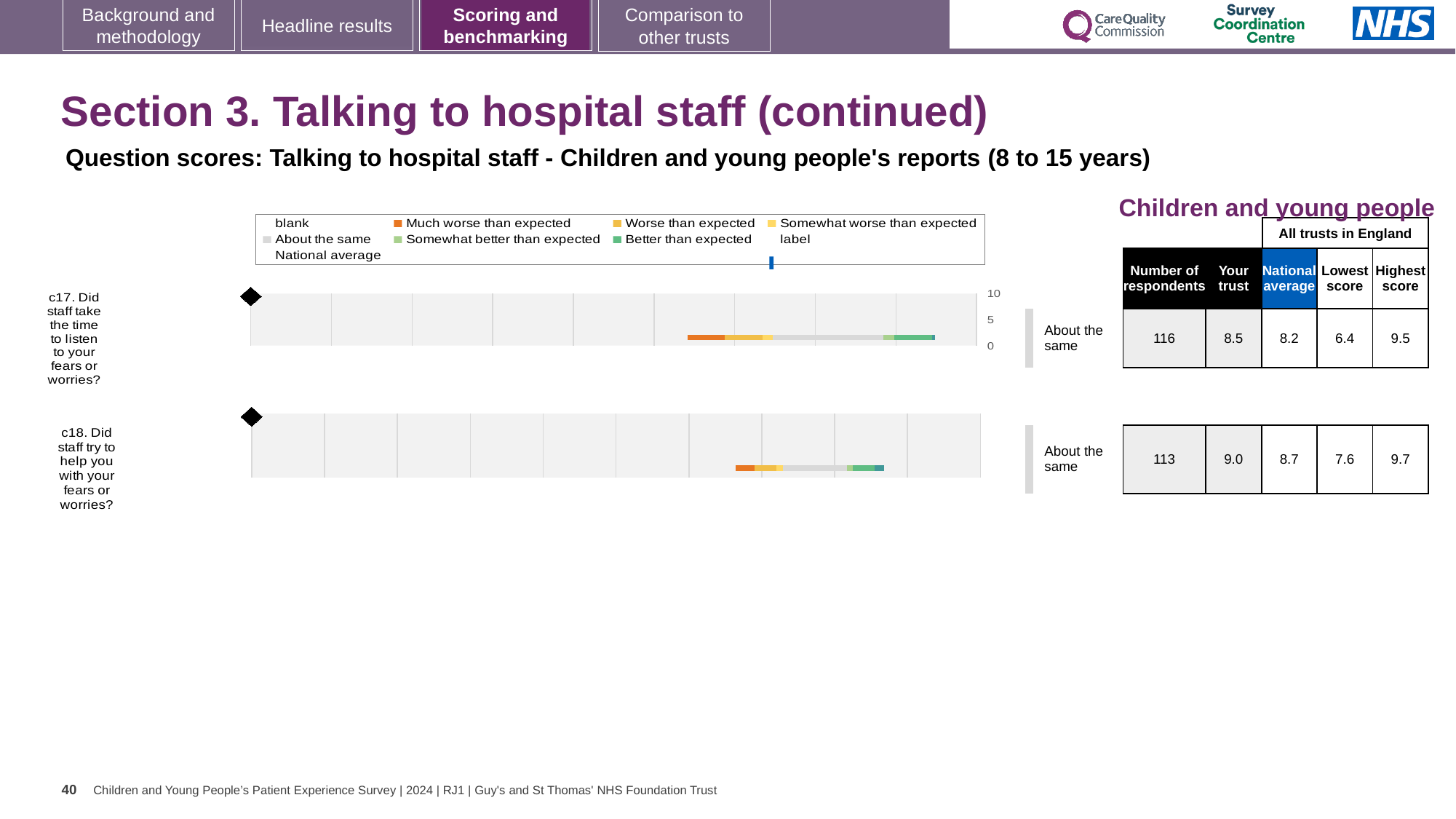
What is the difference between the highest and lowest scores across all trusts in England for c17? 3.1 What is the highest score among all trusts in England for c17? 9.5 What benchmark category is shown next to the c17 chart? About the same What is the 'Your trust' score for c17 (Did staff take the time to listen to your fears or worries?)? 8.5 What is the difference between the trust's score and the national average for c18? 0.3 How many survey questions are plotted on the slide? 2 What is the lowest score among all trusts in England for c18? 7.6 How many respondents answered c17? 116 What type of chart is used to show the question scores for c17 and c18? bar chart Which question has the higher 'Your trust' score, c17 or c18? c18 What is the national average score for c18 (Did staff try to help you with your fears or worries?)? 8.7 For c17, which is larger: the trust's score or the national average? Your trust